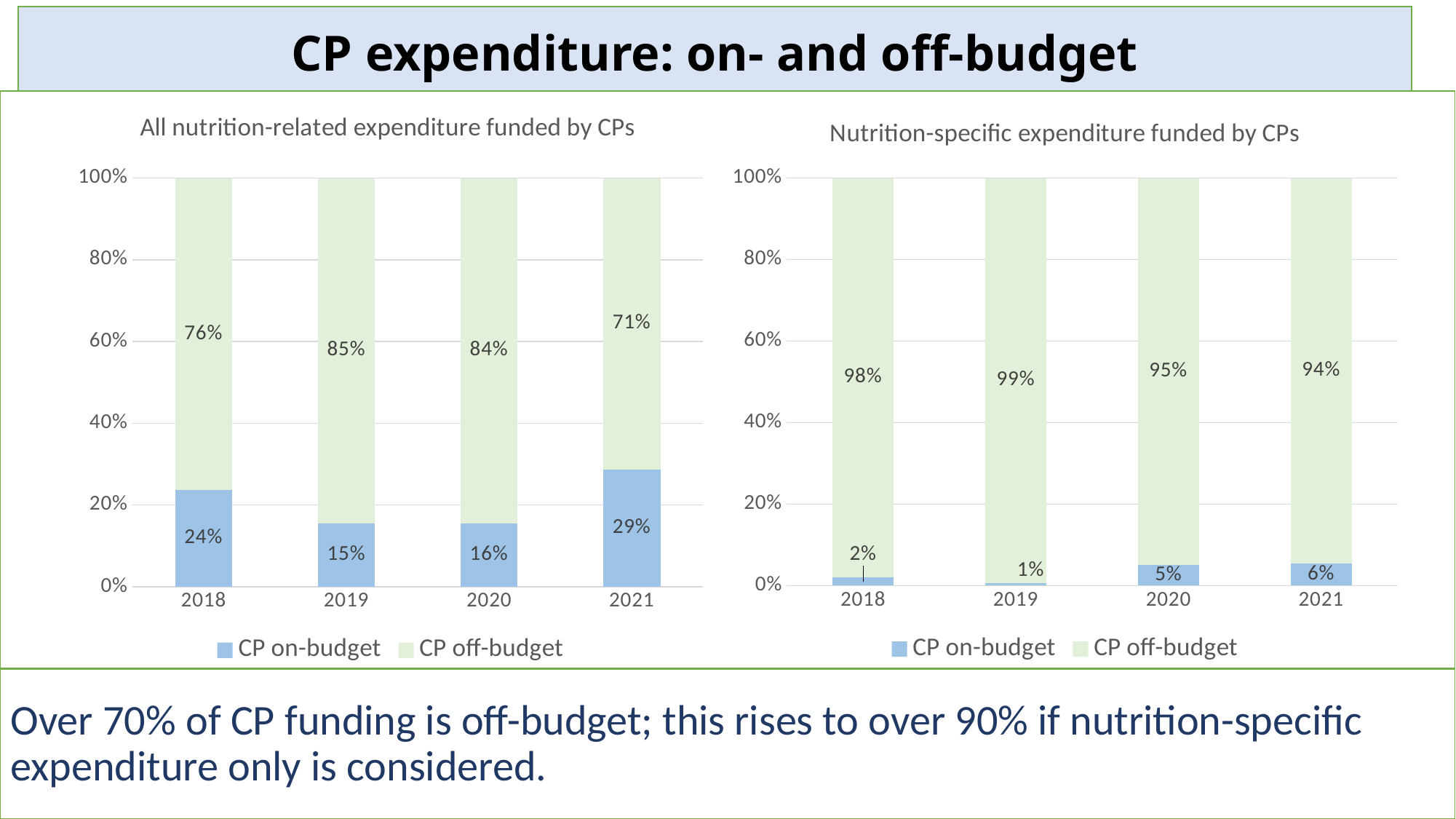
In the 'Nutrition-specific expenditure funded by CPs' chart, is the CP on-budget value for 2020 larger or smaller than the CP on-budget value for 2018? larger How many years are shown on the x axis of the 'All nutrition-related expenditure funded by CPs' chart? 4 In the 'All nutrition-related expenditure funded by CPs' chart, what is the difference between the CP off-budget values for 2019 and 2021? 14% In the 'Nutrition-specific expenditure funded by CPs' chart, what is the CP on-budget value for 2021? 6% In the 'Nutrition-specific expenditure funded by CPs' chart, what is the CP off-budget value for 2020? 95% How many series does the legend of the 'Nutrition-specific expenditure funded by CPs' chart list? 2 In the 'Nutrition-specific expenditure funded by CPs' chart, what is the total of the stacked bar for 2018? 100% In the 'Nutrition-specific expenditure funded by CPs' chart, which year has the lowest CP on-budget share? 2019 In the 'All nutrition-related expenditure funded by CPs' chart, what is the CP on-budget value for 2018? 24% In the 'All nutrition-related expenditure funded by CPs' chart, what is the CP off-budget value for 2019? 85% What kind of chart is the 'All nutrition-related expenditure funded by CPs' chart? Stacked bar chart In the 'All nutrition-related expenditure funded by CPs' chart, which year has the highest CP on-budget share? 2021